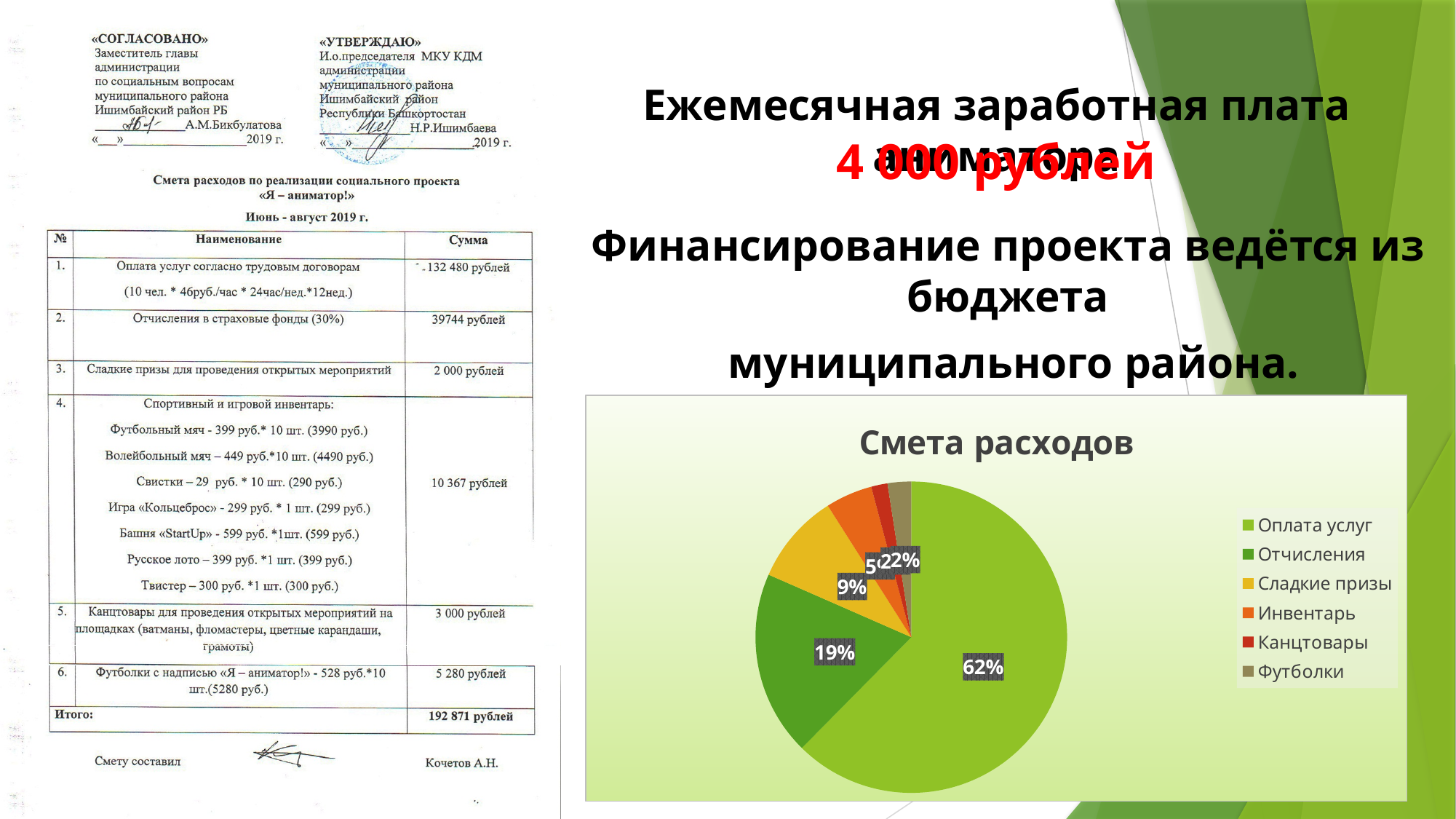
Which category has the largest slice of the pie? Оплата услуг How many categories does the legend of the pie chart list? 6 What kind of chart is shown on the slide? pie chart What is the difference in percentage points between Отчисления and Сладкие призы? 10 What is the value shown for Сладкие призы? 9% Which is larger, the slice for Оплата услуг or the slice for Инвентарь? Оплата услуг What share of the pie does Оплата услуг take? 62% Which is larger, the slice for Отчисления or the slice for Сладкие призы? Отчисления Which legend entry is shown in yellow? Сладкие призы What is the value shown for Отчисления? 19% What is the title of the chart? Смета расходов What is the difference in percentage points between Оплата услуг and Отчисления? 43